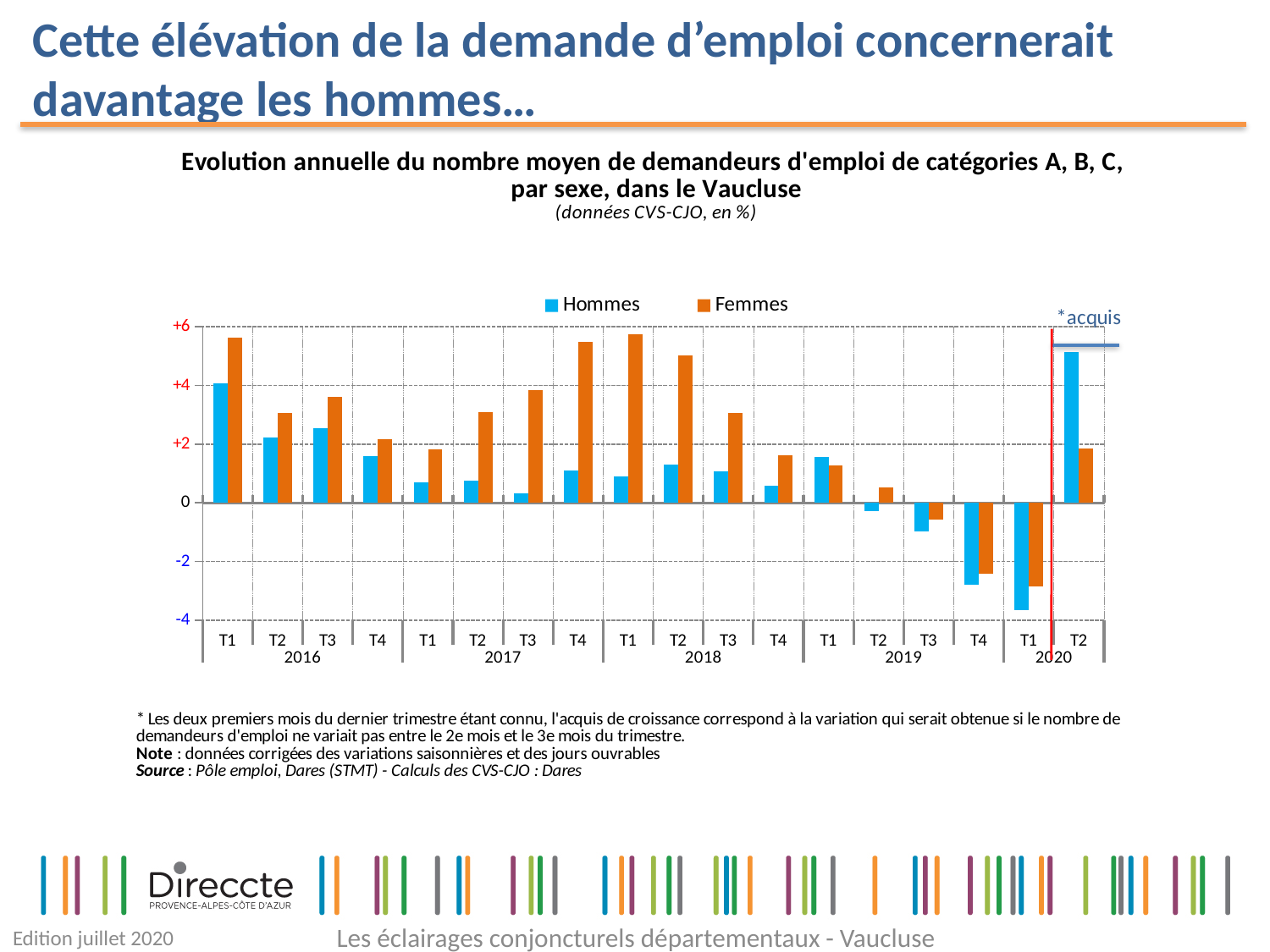
In T1 2016, which is larger, the value for Hommes or for Femmes? Femmes What kind of chart is shown on the slide? bar chart In T2 2020, which is larger, the value for Hommes or for Femmes? Hommes How many quarters (categories) are plotted along the x axis? 18 In which quarter is the value for Femmes lowest? T1 2020 Which series is shown in orange? Femmes Do the values for Femmes rise or fall from T1 2018 to T1 2020? fall Is the value for Hommes in T1 2020 greater or less than -2? less Is the value for Femmes in T1 2016 greater or less than +4? greater How many series does the legend list? 2 In which quarter is the value for Hommes highest? T2 2020 In which quarter is the value for Hommes lowest? T1 2020